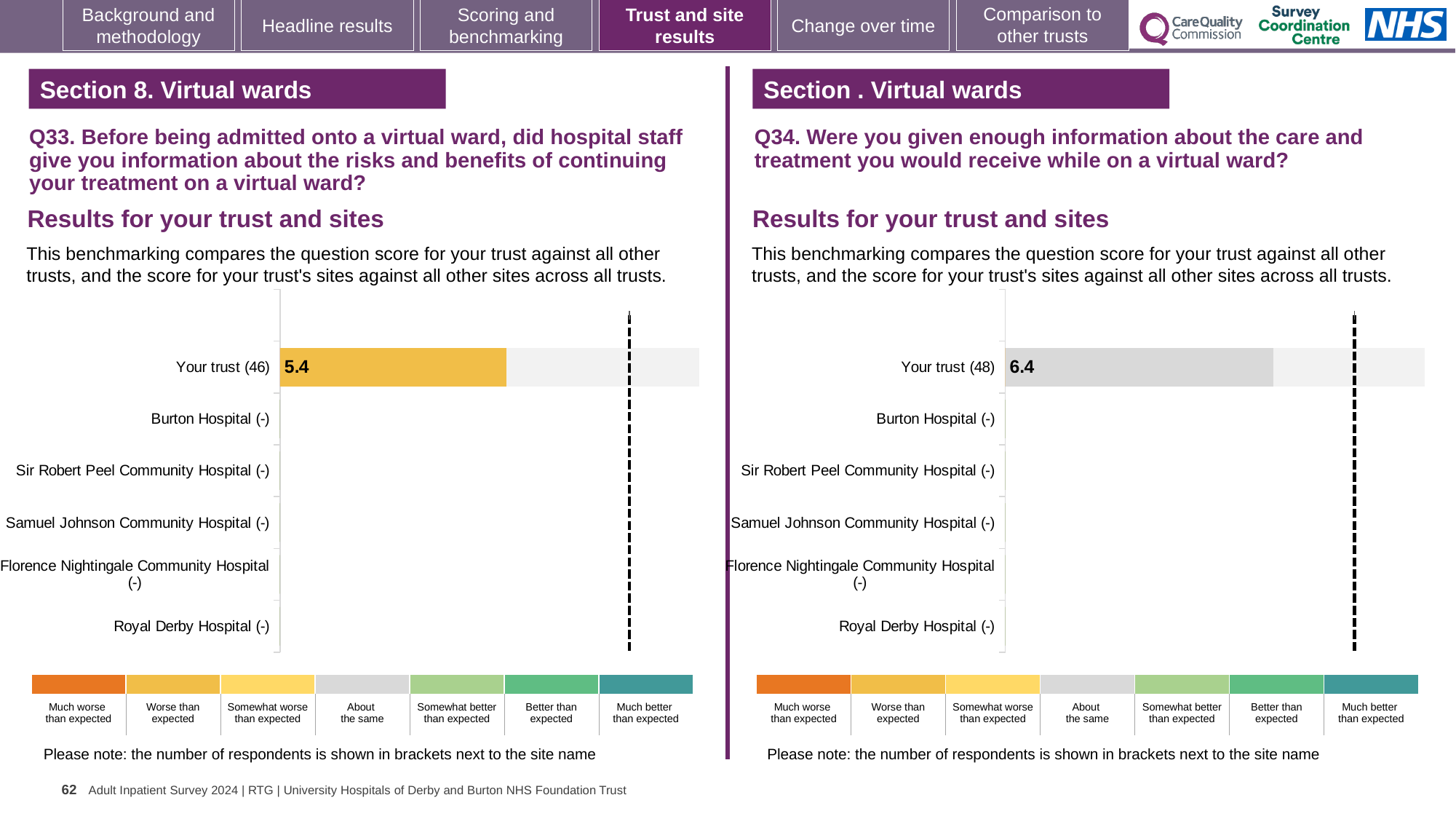
Which is larger: the Your trust score in the Q33 chart on the left or the Your trust score in the Q34 chart on the right? Q34 chart (6.4) How many categories (sites including Your trust) are listed on the y axis of the Q33 chart on the left? 6 In the Q34 chart on the right, how many respondents are shown in brackets next to Your trust? 48 How many categories (sites including Your trust) are listed on the y axis of the Q34 chart on the right? 6 In the Q33 chart on the left, what is the number of respondents shown for Royal Derby Hospital? - What kind of chart is used for the Q33 results on the left? Bar chart In the Q34 chart on the right, what is the score for Your trust? 6.4 In the Q33 chart on the left, which benchmark category does the colour of the Your trust bar correspond to in the legend? Worse than expected In the Q33 chart on the left, what is the score for Your trust? 5.4 What is the difference between the Your trust score in the Q34 chart on the right and the Your trust score in the Q33 chart on the left? 1.0 In the Q33 chart on the left, how many respondents are shown in brackets next to Your trust? 46 In the Q34 chart on the right, which benchmark category does the colour of the Your trust bar correspond to in the legend? About the same